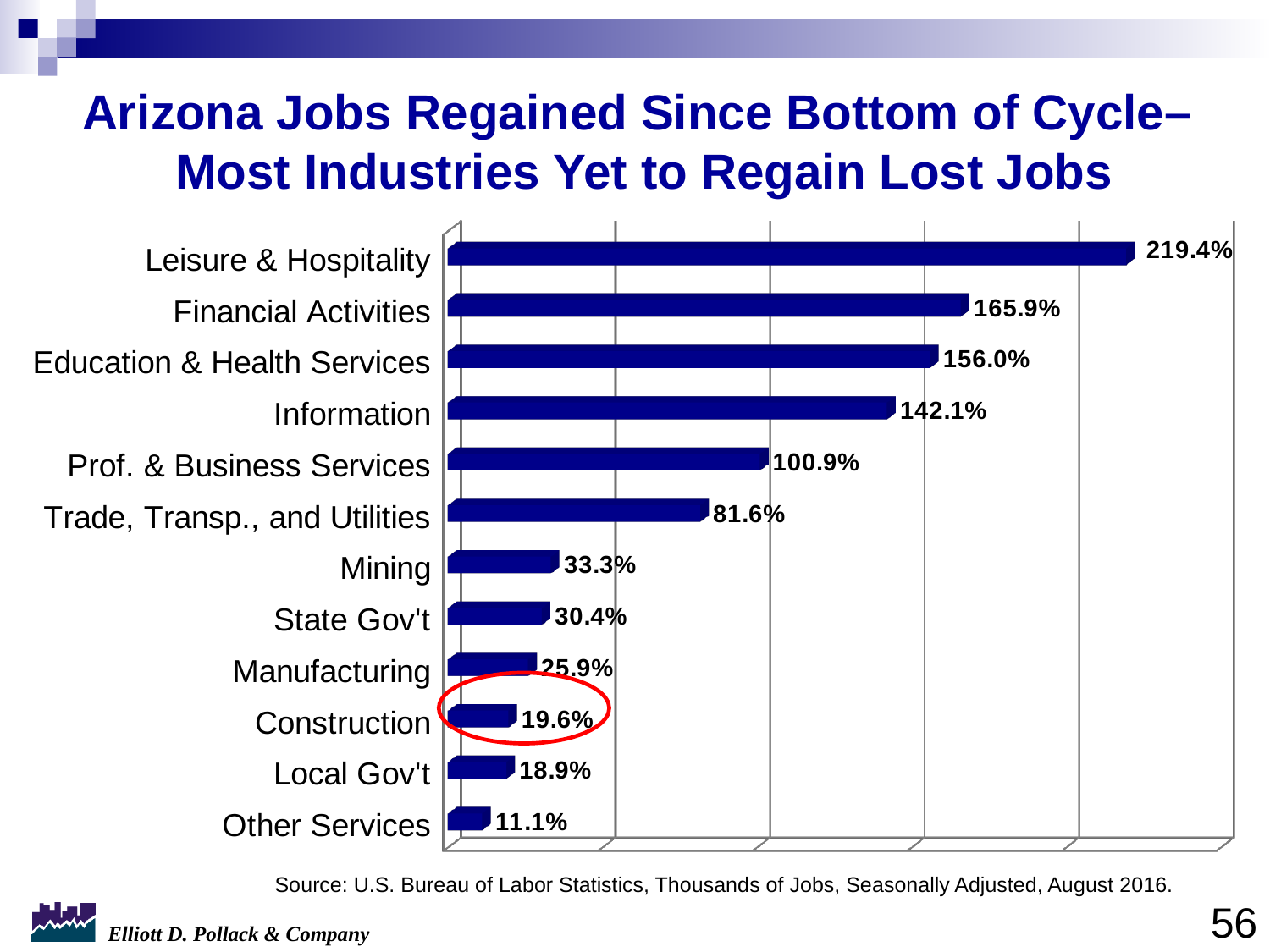
Which industry's bar is circled in red on the chart? Construction What is the value for Leisure & Hospitality? 219.4% Which is larger, the value for Manufacturing or the value for Local Gov't? Manufacturing What is the value for Construction? 19.6% Which is larger, the value for Information or the value for Trade, Transp., and Utilities? Information How many industries are shown in the chart? 12 Which industry has the highest value? Leisure & Hospitality What kind of chart is shown on the slide? Bar chart What is the difference between the values for Mining and State Gov't? 2.9% What is the value for Prof. & Business Services? 100.9% Which industry has the lowest value? Other Services What is the difference between the values for Financial Activities and Education & Health Services? 9.9%